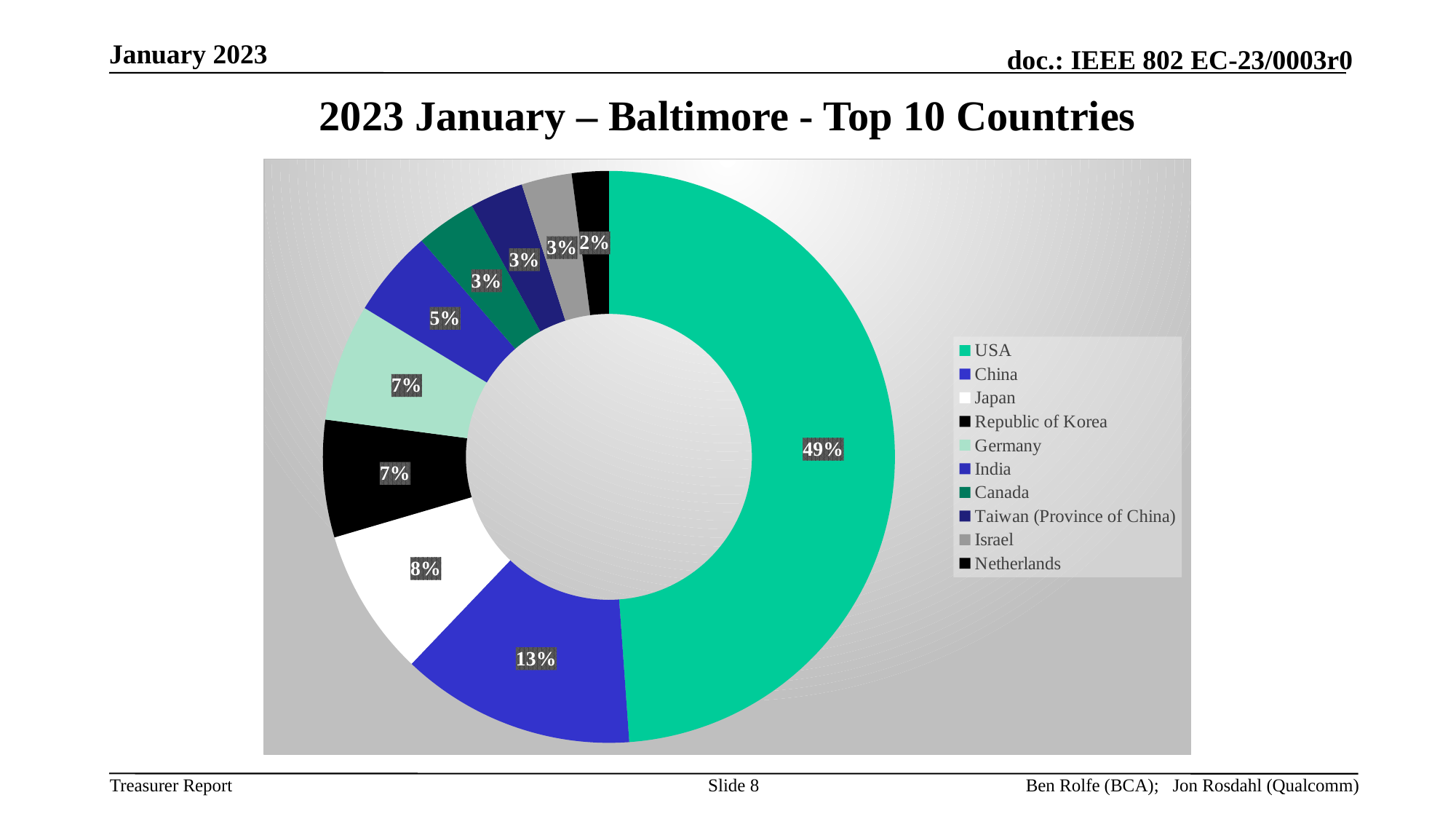
What percentage is shown for India? 5% How many countries are shown in the chart? 10 What percentage is shown for Netherlands? 2% What kind of chart is shown on the slide? Doughnut chart What is the difference in percentage points between USA and China? 36 Which has a larger share, Japan or India? Japan Which country has the largest share of the chart? USA What is the title of the slide containing the chart? 2023 January – Baltimore - Top 10 Countries What percentage is shown for Japan? 8% What percentage is shown for China? 13% Which country has the smallest share of the chart? Netherlands What share of the chart does USA account for? 49%